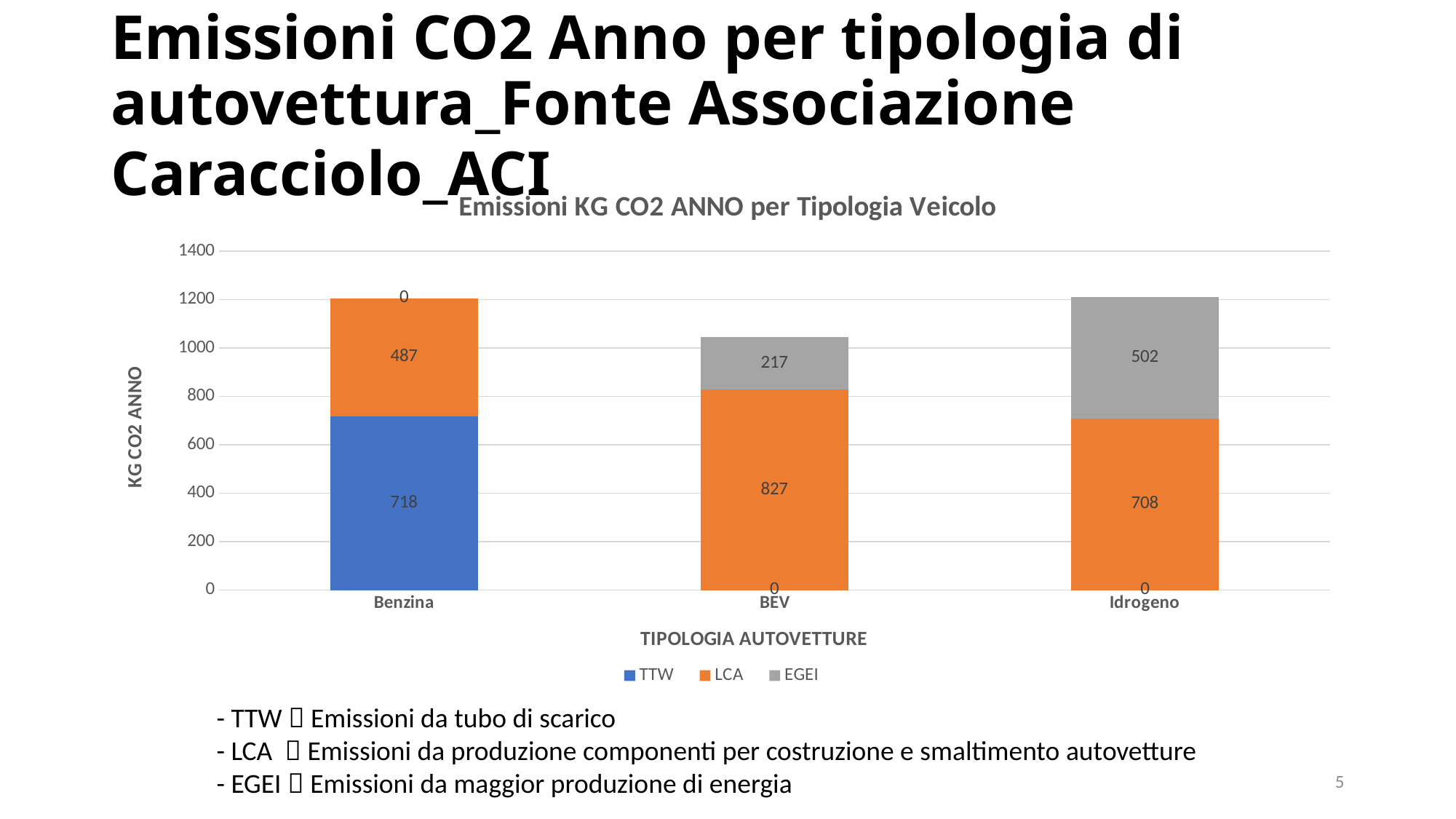
What kind of chart is shown on the slide? Stacked bar chart What is the total of the stacked bar for BEV? 1044 Which vehicle type has the highest LCA value? BEV What is the EGEI value for Idrogeno? 502 How many series does the legend list? 3 What is the total of the stacked bar for Benzina? 1205 What is the LCA value for BEV? 827 What is the EGEI value for BEV? 217 What is the LCA value for Idrogeno? 708 What is the difference between the LCA value for BEV and the LCA value for Idrogeno? 119 Which has the larger EGEI value, BEV or Idrogeno? Idrogeno What is the TTW value for Benzina? 718